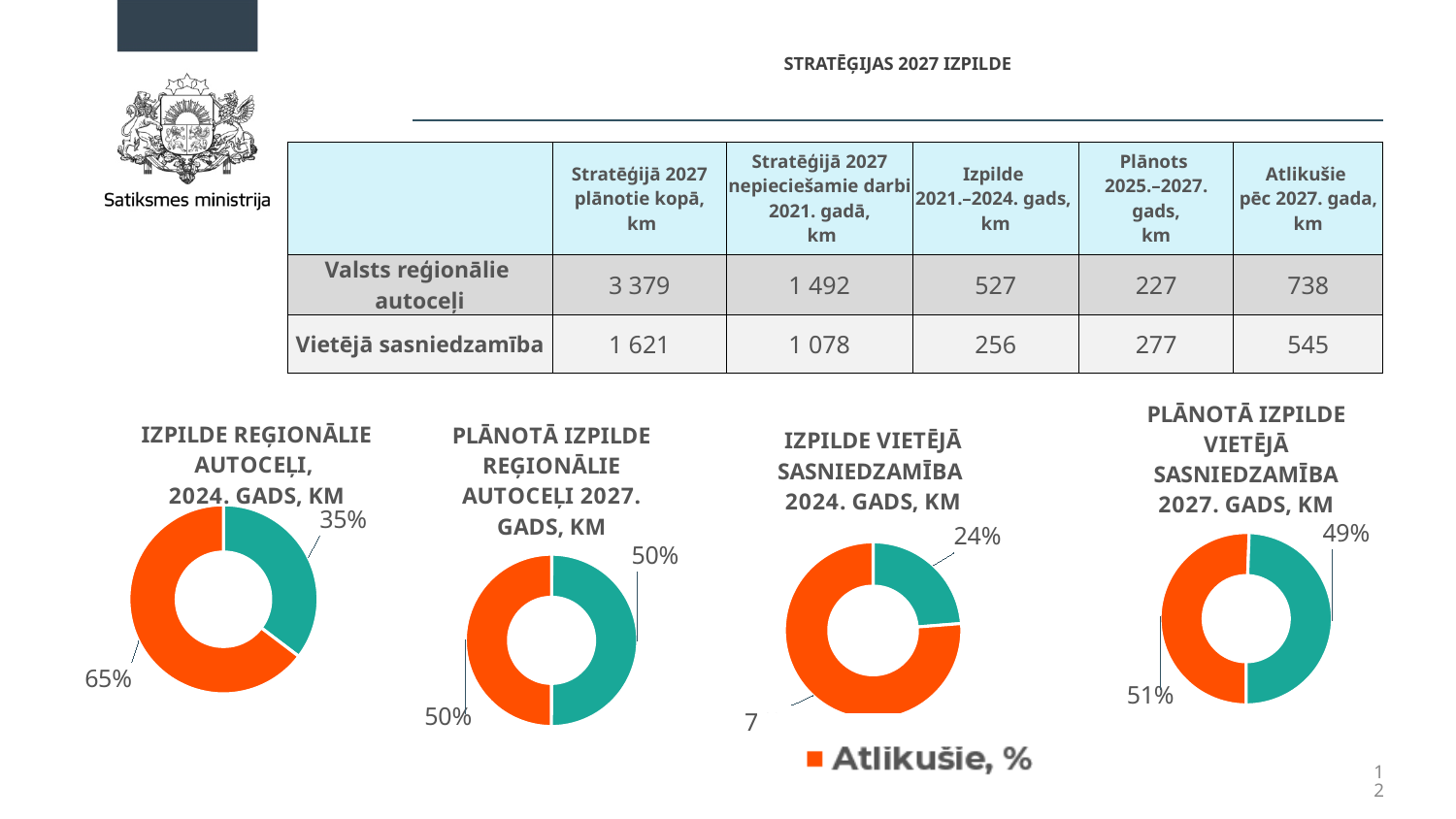
In the chart 'IZPILDE REĢIONĀLIE AUTOCEĻI, 2024. GADS, KM', what share does the teal slice represent? 35% In the chart 'PLĀNOTĀ IZPILDE VIETĒJĀ SASNIEDZAMĪBA 2027. GADS, KM', what share does the orange slice represent? 51% In the chart 'PLĀNOTĀ IZPILDE REĢIONĀLIE AUTOCEĻI 2027. GADS, KM', what share does each slice represent? 50% each How many slices does the chart 'PLĀNOTĀ IZPILDE VIETĒJĀ SASNIEDZAMĪBA 2027. GADS, KM' have? 2 How many doughnut charts are shown on the slide? 4 In the chart 'IZPILDE REĢIONĀLIE AUTOCEĻI, 2024. GADS, KM', what is the difference in percentage points between the orange and teal slices? 30 percentage points What kind of chart is 'IZPILDE REĢIONĀLIE AUTOCEĻI, 2024. GADS, KM'? Doughnut (pie) chart According to the legend on the slide, what does the orange colour represent? Atlikušie, % In the chart 'IZPILDE REĢIONĀLIE AUTOCEĻI, 2024. GADS, KM', which slice is larger, the orange one or the teal one? The orange one